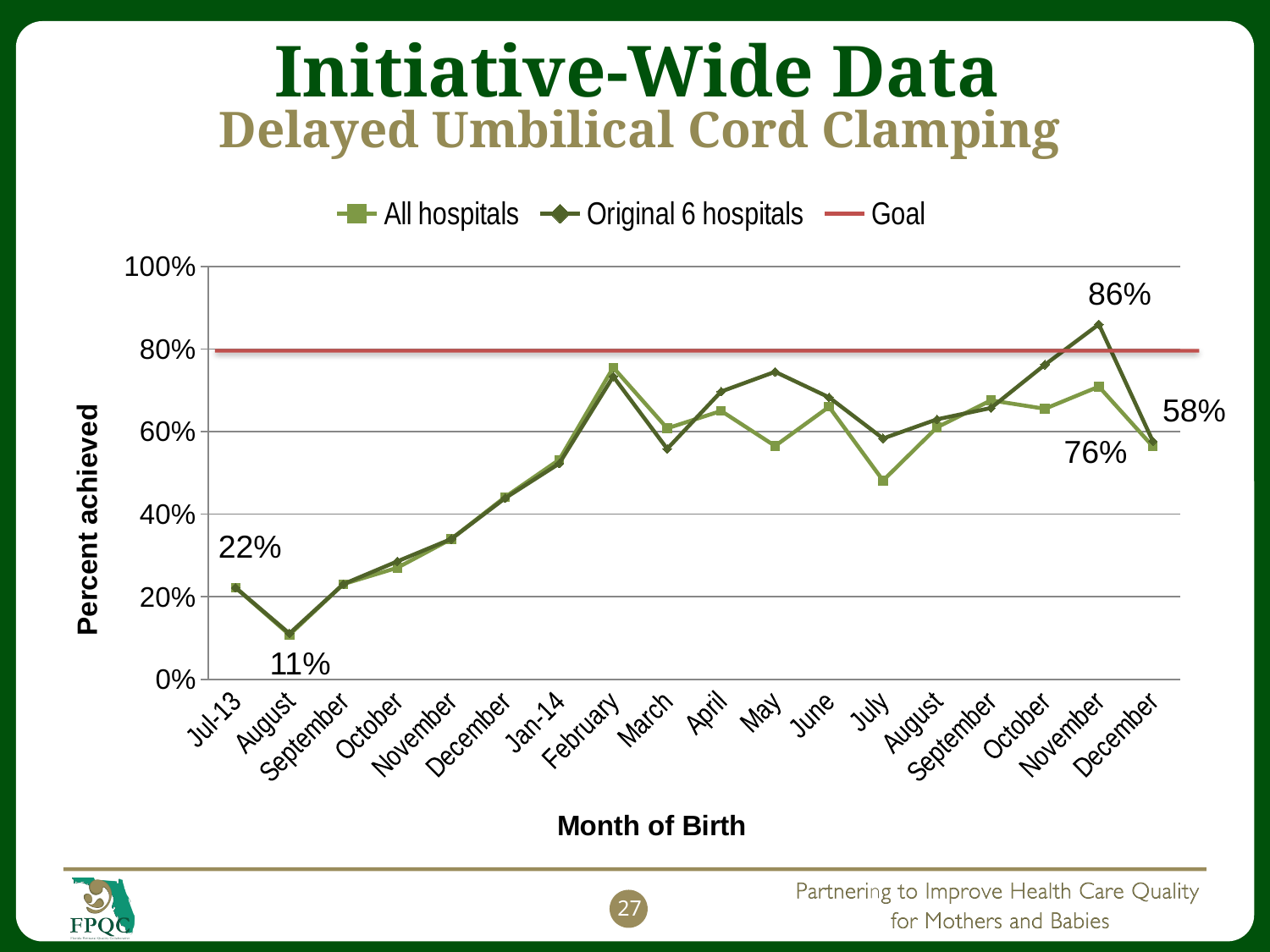
What value does the Goal line sit at? 80% Is the value for All hospitals in July 2014 greater or less than 60%? less What is the labelled value for Jul-13? 22% In which month is the lowest value on the chart recorded? August (2013) How many series does the legend list? 3 In which month does the Original 6 hospitals series reach its highest value? November What is the difference between the labelled value for Original 6 hospitals in November 2014 (86%) and the labelled value for August 2013 (11%)? 75 percentage points What kind of chart is shown on the slide? Line chart In November 2014, which series is higher: All hospitals or Original 6 hospitals? Original 6 hospitals What is the labelled value for August 2013, the second month on the x axis? 11% How many months are plotted along the x axis? 18 What is the labelled value for the Original 6 hospitals in November 2014? 86%